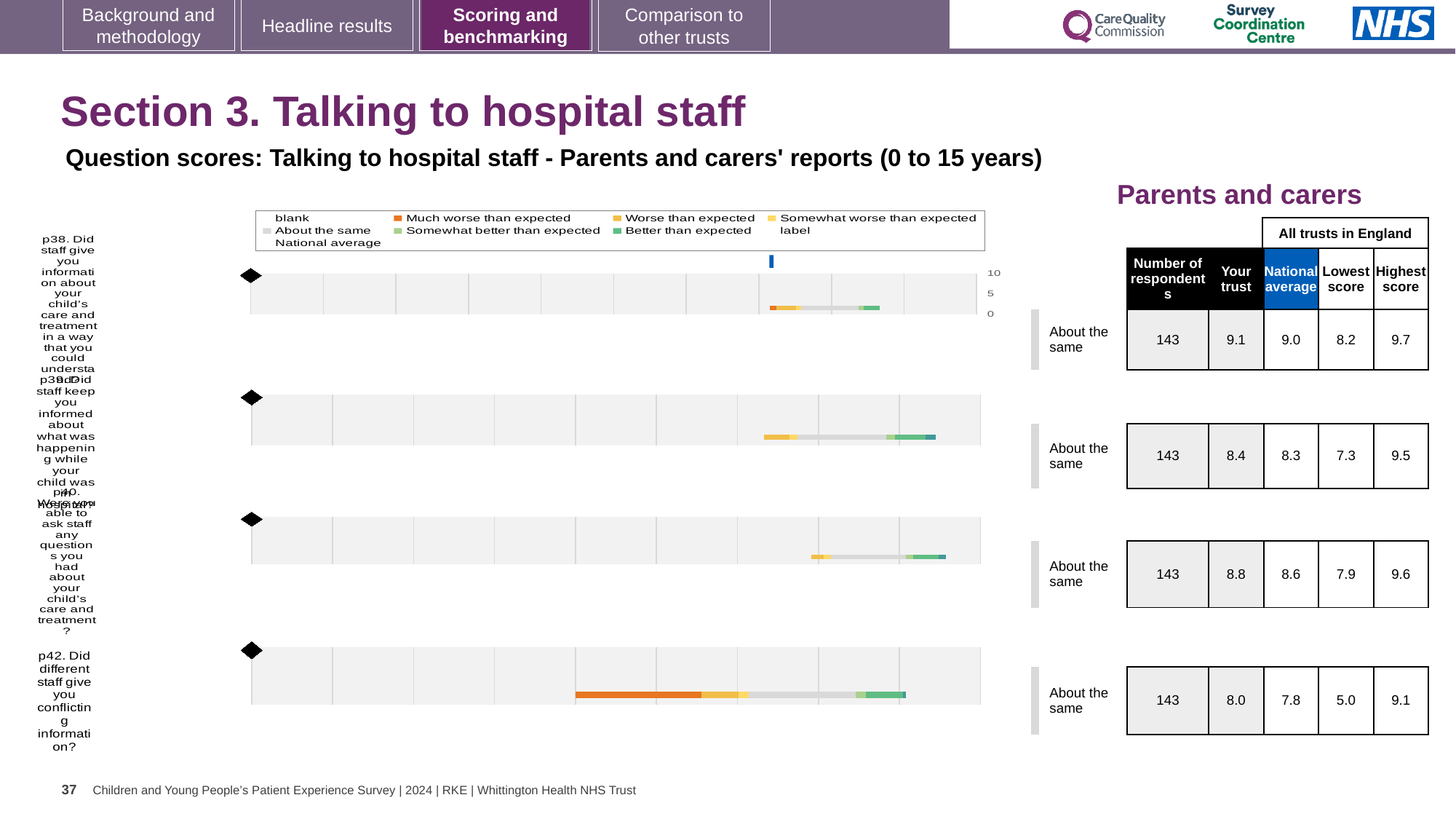
For the p38 chart (staff giving information about your child's care in a way you could understand), what is the 'Your trust' score shown in the table? 9.1 For the p40 chart (being able to ask staff any questions), what is the highest score among all trusts in England? 9.6 What benchmark category is shown next to each of the four charts? About the same Which question chart has the highest 'Your trust' score? p38 For the p39 chart (staff keeping you informed about what was happening), what is the national average score? 8.3 Which question chart has the lowest 'Your trust' score? p42 What kind of chart is used to show the question scores on this slide? bar chart For the p42 chart, which is larger: the 'Your trust' score or the national average? Your trust How many respondents are shown for the p40 chart? 143 For the p42 chart (different staff giving conflicting information), what is the lowest score among all trusts in England? 5.0 How many question charts (p38, p39, p40, p42) are shown on the slide? 4 For the p38 chart, what is the difference between the 'Your trust' score and the national average? 0.1